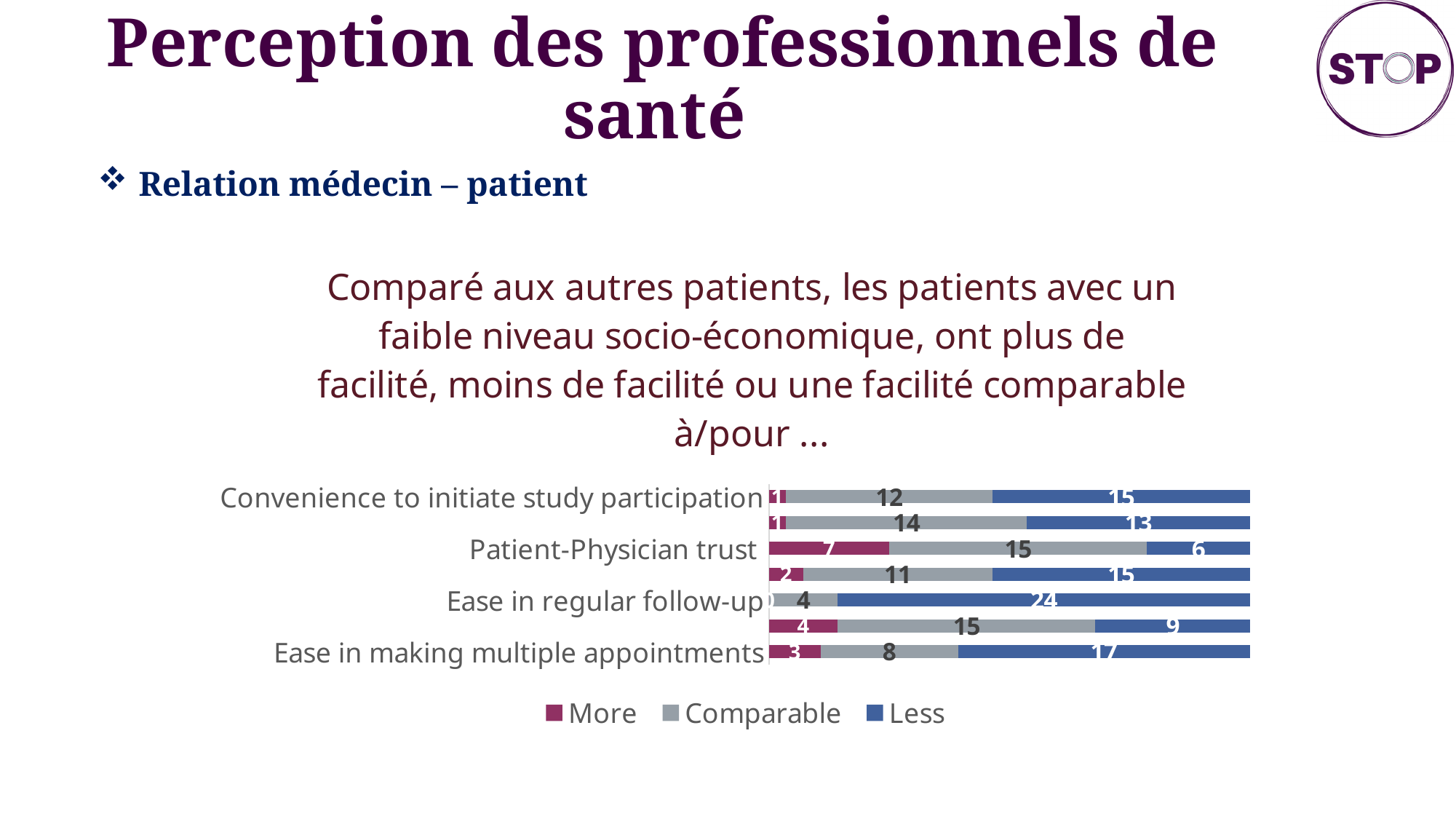
What is the 'Comparable' value for 'Patient-Physician trust'? 15 Which has the larger 'Less' value: 'Ease in regular follow-up' or 'Patient-Physician trust'? Ease in regular follow-up What is the 'More' value for 'Patient-Physician trust'? 7 What is the total of the stacked bar for 'Patient-Physician trust'? 28 How many series does the chart legend list? 3 What are the three legend entries of the chart? More, Comparable, Less What is the 'Comparable' value for 'Ease in making multiple appointments'? 8 What is the difference between the 'Less' and 'More' values for 'Ease in making multiple appointments'? 14 What is the 'Less' value for 'Convenience to initiate study participation'? 15 What is the total of the stacked bar for 'Ease in making multiple appointments'? 28 What kind of chart is shown on the slide? Stacked bar chart What is the 'Less' value for 'Ease in regular follow-up'? 24